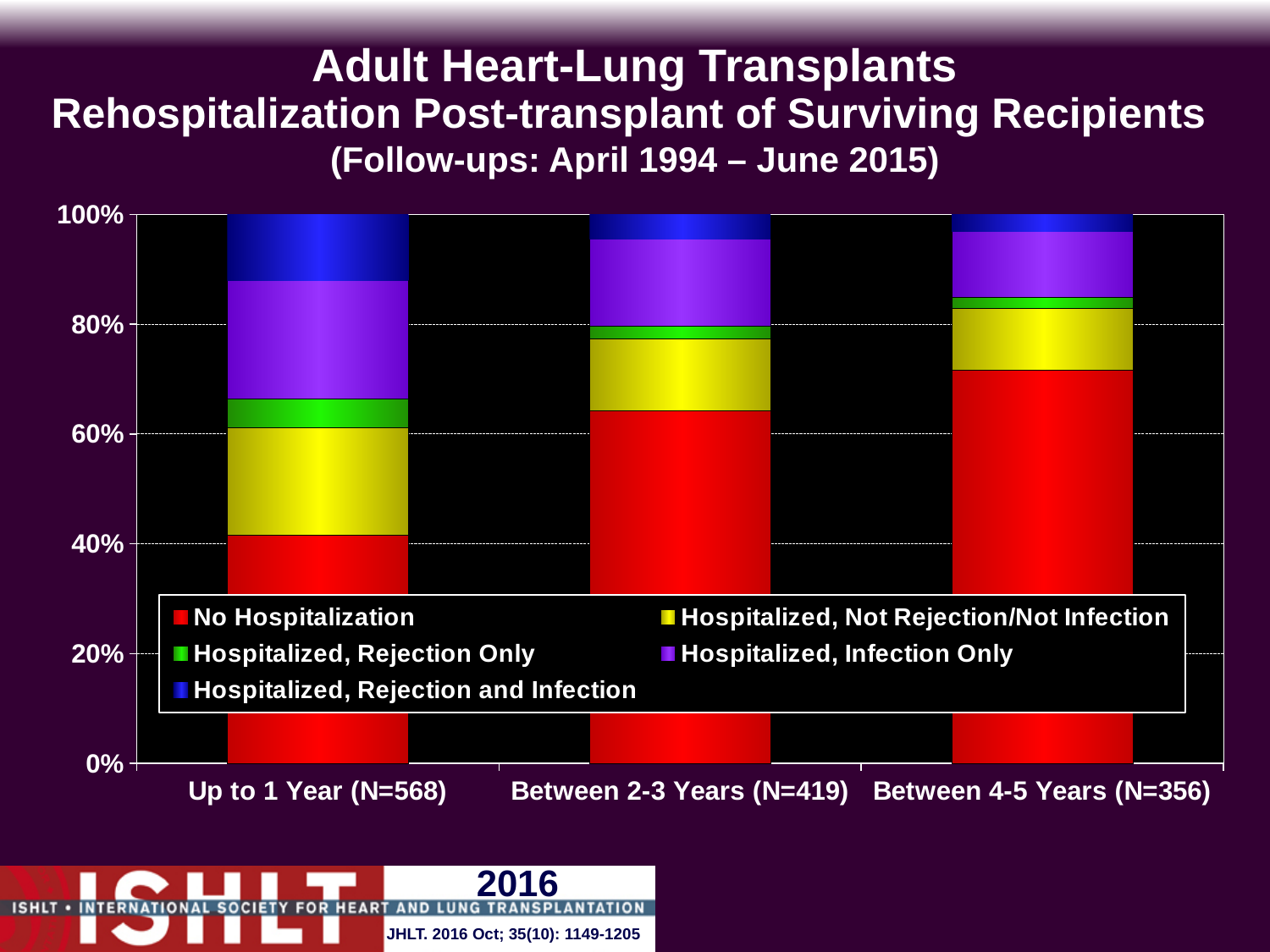
How many series does the legend list? 5 Is the No Hospitalization share for Between 2-3 Years (N=419) greater or less than 80%? less Does the No Hospitalization share rise or fall from Up to 1 Year to Between 4-5 Years? rise How many follow-up period categories are shown on the x axis? 3 Is the No Hospitalization share for Up to 1 Year (N=568) greater or less than 60%? less What colour represents Hospitalized, Infection Only in the legend? Purple Is the No Hospitalization share for Between 4-5 Years (N=356) greater or less than 60%? greater Which follow-up period has the largest No Hospitalization share? Between 4-5 Years (N=356) Which follow-up period has the smallest No Hospitalization share? Up to 1 Year (N=568) What follow-up date range is given in the chart title? April 1994 – June 2015 What kind of chart is shown on the slide? Stacked bar chart Which is larger: the Hospitalized, Not Rejection/Not Infection share for Up to 1 Year or for Between 4-5 Years? Up to 1 Year